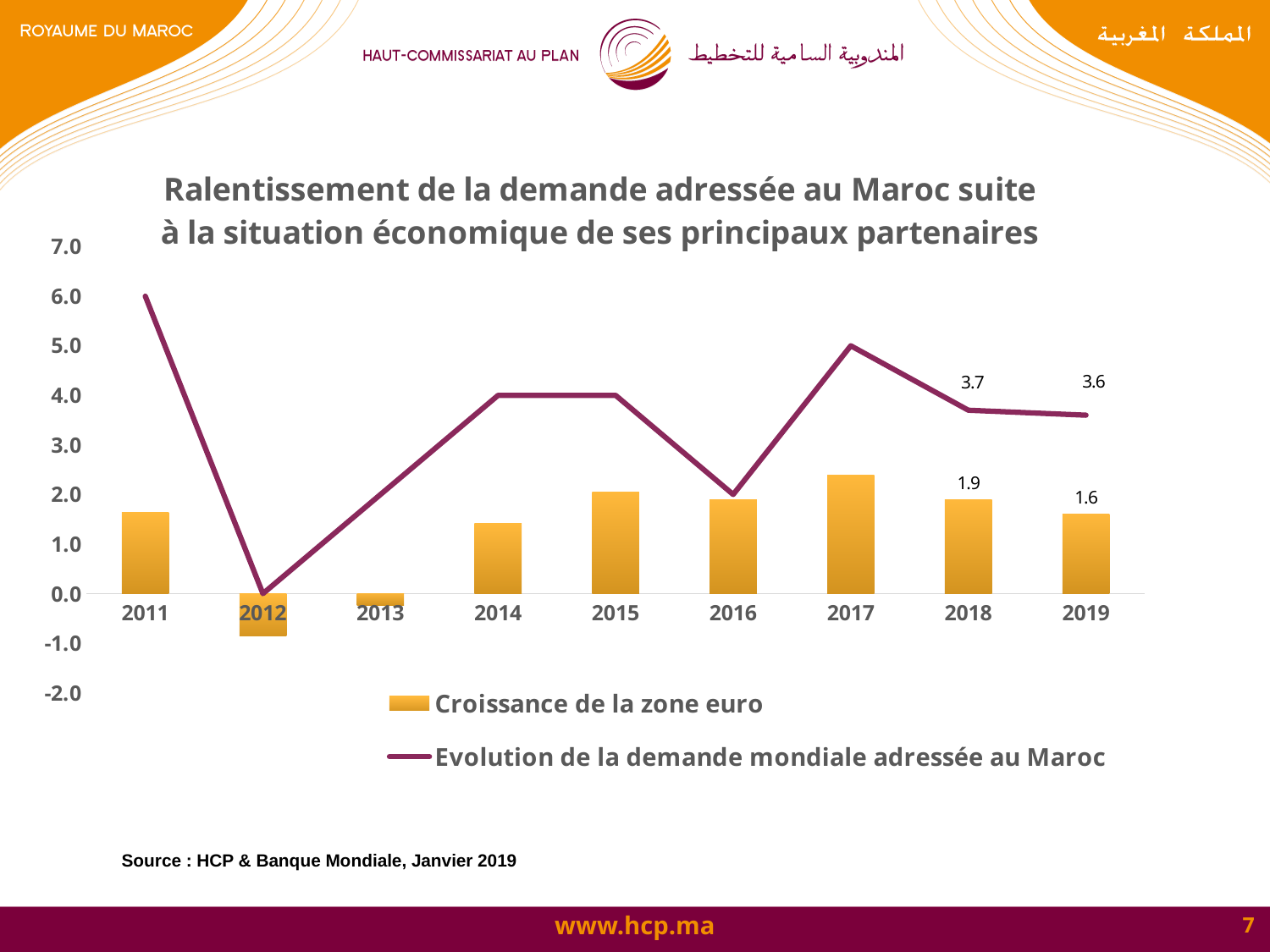
How many years are shown on the x axis of the chart? 9 What is the value of Evolution de la demande mondiale adressée au Maroc in 2018? 3.7 What is the value of Croissance de la zone euro in 2018? 1.9 In which year is Croissance de la zone euro lowest? 2012 Is the value of Evolution de la demande mondiale adressée au Maroc in 2011 greater or less than 5.0? greater By how much does Croissance de la zone euro in 2018 exceed its value in 2019? 0.3 In which year is Evolution de la demande mondiale adressée au Maroc highest? 2011 Is the value of Croissance de la zone euro in 2012 greater or less than 0.0? less What is the difference between the Evolution de la demande mondiale adressée au Maroc values for 2018 and 2019? 0.1 How many series does the legend list? 2 Does Evolution de la demande mondiale adressée au Maroc rise or fall from 2017 to 2019? fall What is the value of Croissance de la zone euro in 2019? 1.6